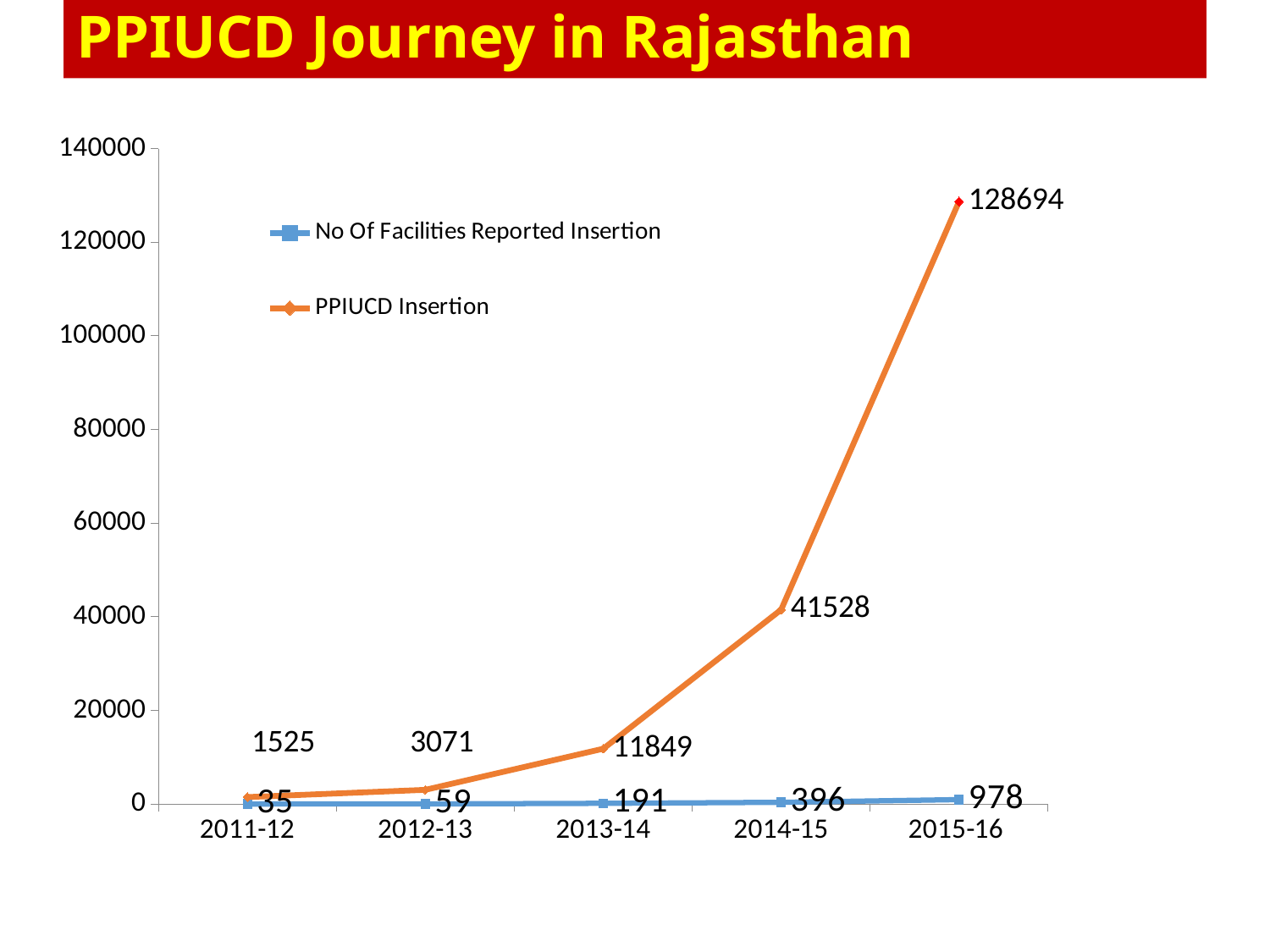
In which year is No Of Facilities Reported Insertion lowest? 2011-12 What kind of chart is shown on the slide? line chart What is the PPIUCD Insertion value for 2012-13? 3071 What is the difference in No Of Facilities Reported Insertion between 2015-16 and 2014-15? 582 In which year is PPIUCD Insertion highest? 2015-16 Is the PPIUCD Insertion value for 2014-15 greater or less than 40000? greater What is the PPIUCD Insertion value for 2015-16? 128694 What is the difference in PPIUCD Insertion between 2015-16 and 2014-15? 87166 How many years are shown on the x axis? 5 What is the No Of Facilities Reported Insertion value for 2013-14? 191 How many series does the legend list? 2 Which is larger: PPIUCD Insertion in 2013-14 or in 2012-13? 2013-14